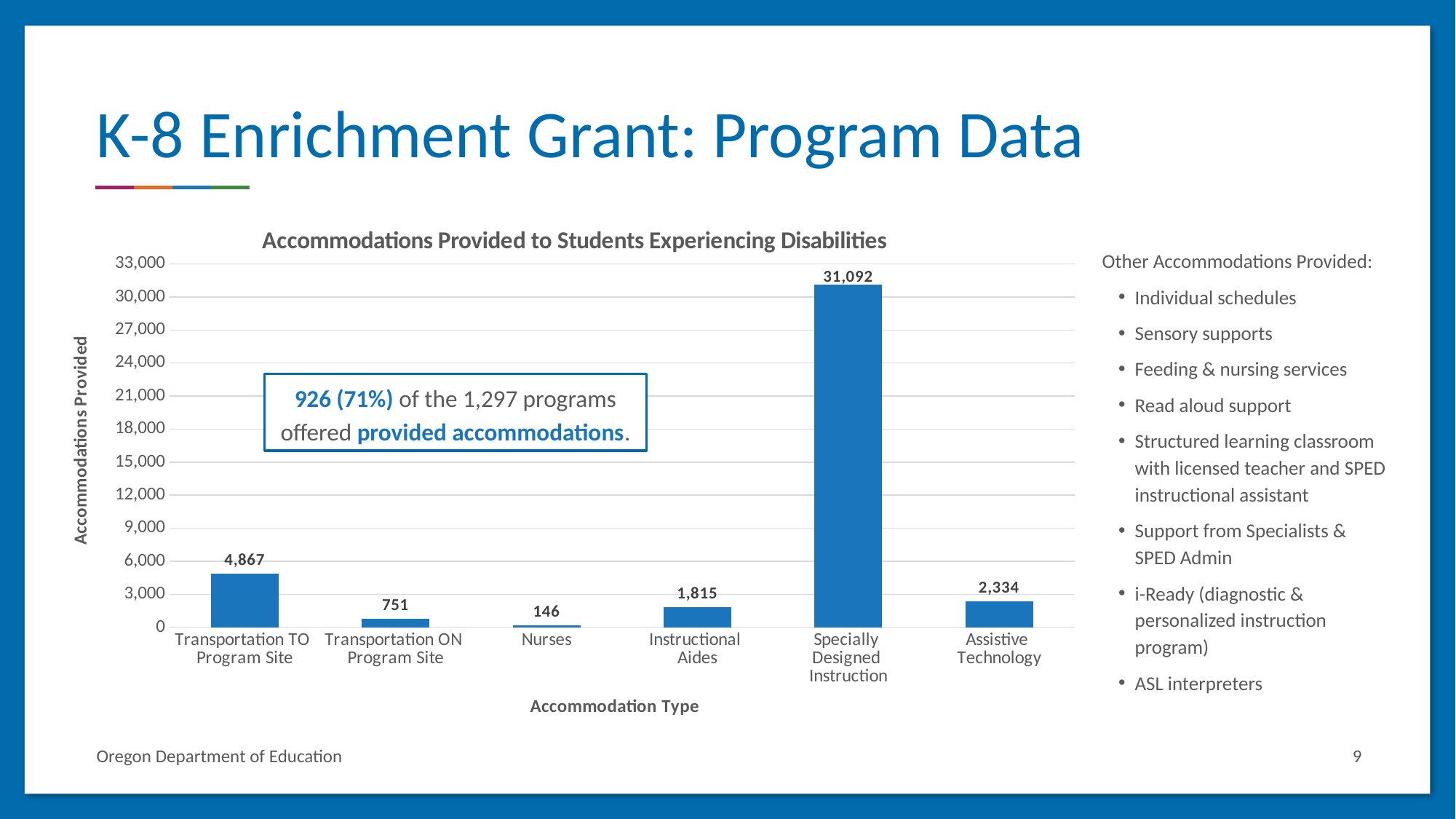
What is the value for Assistive Technology? 2,334 Which accommodation type has the highest number of accommodations provided? Specially Designed Instruction Which accommodation type has the lowest number of accommodations provided? Nurses What is the value for Specially Designed Instruction? 31,092 What kind of chart is shown on the slide? Bar chart How many accommodation types are shown on the chart? 6 What is the title of the chart? Accommodations Provided to Students Experiencing Disabilities What is the value for Nurses? 146 What is the difference between Transportation TO Program Site and Transportation ON Program Site? 4,116 Which is larger, Instructional Aides or Assistive Technology? Assistive Technology What is the value for Transportation TO Program Site? 4,867 Is the value for Transportation TO Program Site greater or less than 3,000? greater